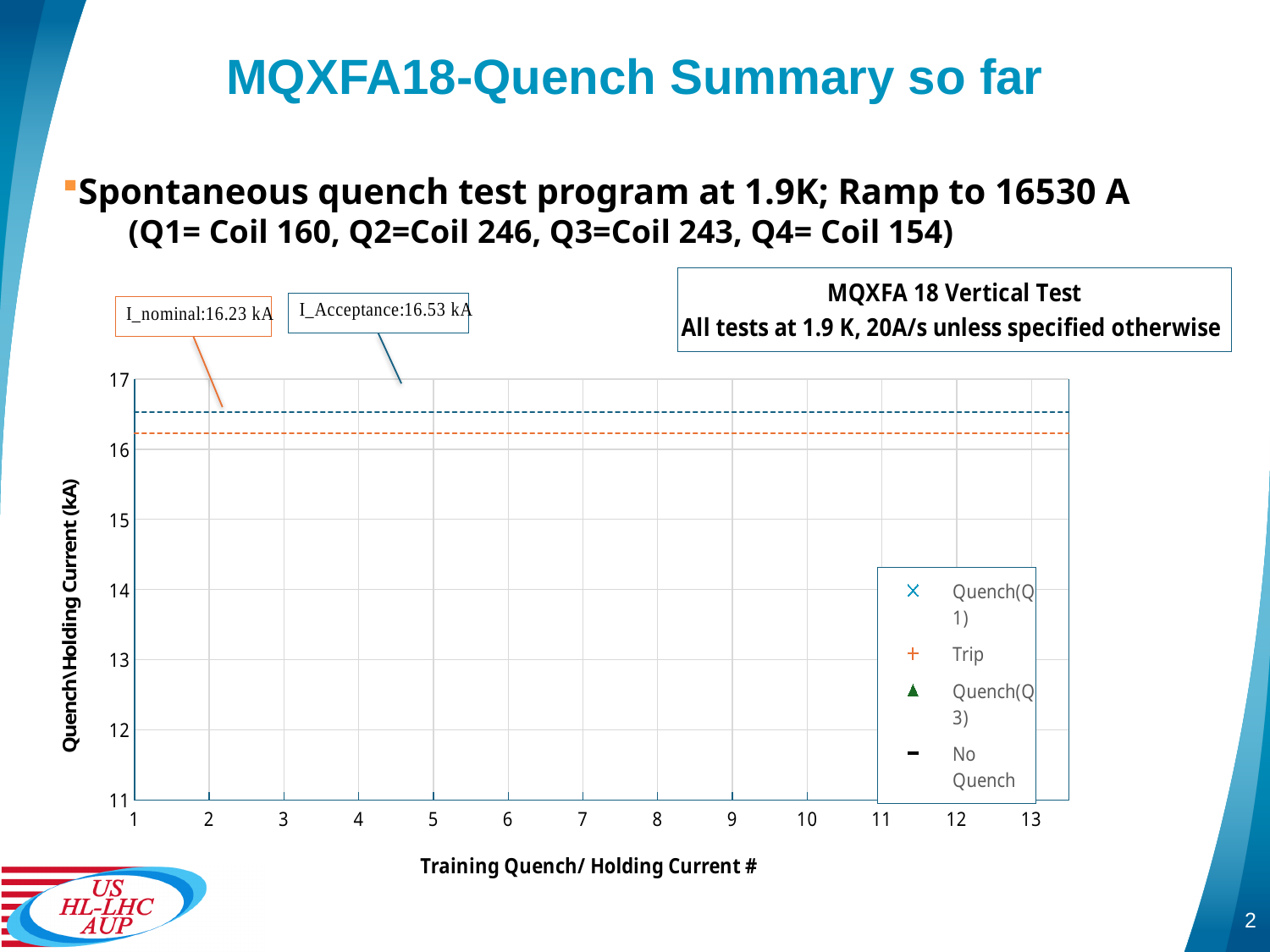
What is the label of the chart's x axis? Training Quench/ Holding Current # What value is the I_nominal reference line labelled with on the chart? 16.23 kA How many numbered positions are shown on the x axis of the chart? 13 What is the difference between the I_Acceptance and I_nominal reference values shown on the chart? 0.30 kA Is the I_nominal reference line above or below the 16 kA gridline on the y axis? above How many entries does the chart legend list? 4 What value is the I_Acceptance reference line labelled with on the chart? 16.53 kA Which reference line is higher on the chart, I_nominal or I_Acceptance? I_Acceptance How many quench or trip data points are plotted on the chart? 0 What is the label of the chart's y axis? Quench\Holding Current (kA) Is the I_Acceptance reference line greater or less than 17 kA on the y axis? less